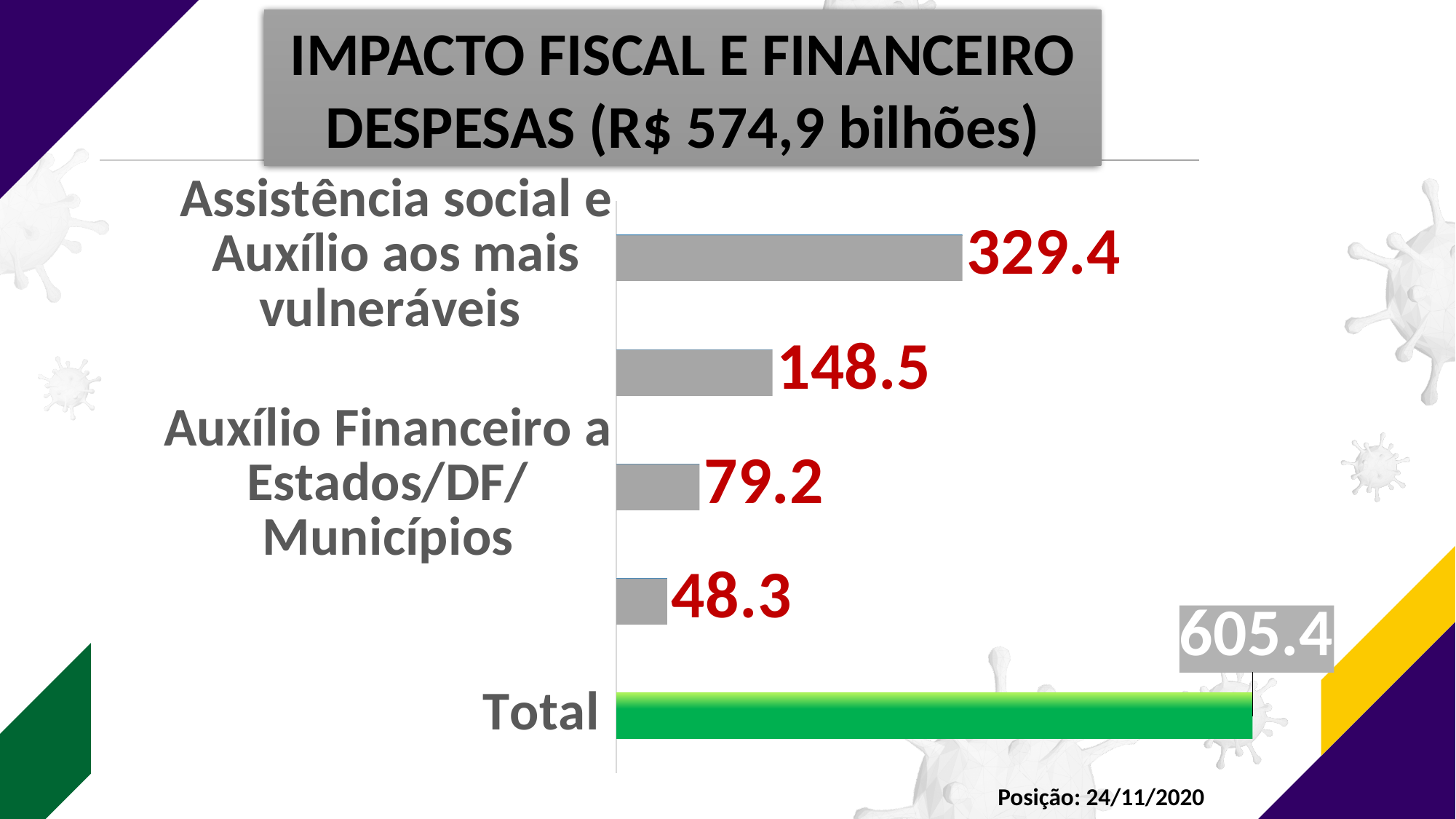
Which bar has the highest value? Total What kind of chart is shown on the slide? bar chart What colour is the Total bar? green What is the smallest value shown on any bar in the chart? 48.3 What is the title of the chart on the slide? IMPACTO FISCAL E FINANCEIRO DESPESAS (R$ 574,9 bilhões) How many bars are plotted in the chart? 5 Which is larger: the value for "Assistência social e Auxílio aos mais vulneráveis" or the value for "Auxílio Financeiro a Estados/DF/Municípios"? Assistência social e Auxílio aos mais vulneráveis What is the value of the bar labelled "Total"? 605.4 Excluding the Total bar, which category has the highest value? Assistência social e Auxílio aos mais vulneráveis What is the difference between the value for "Assistência social e Auxílio aos mais vulneráveis" and the value for "Auxílio Financeiro a Estados/DF/Municípios"? 250.2 What is the value for "Assistência social e Auxílio aos mais vulneráveis"? 329.4 What is the value for "Auxílio Financeiro a Estados/DF/Municípios"? 79.2